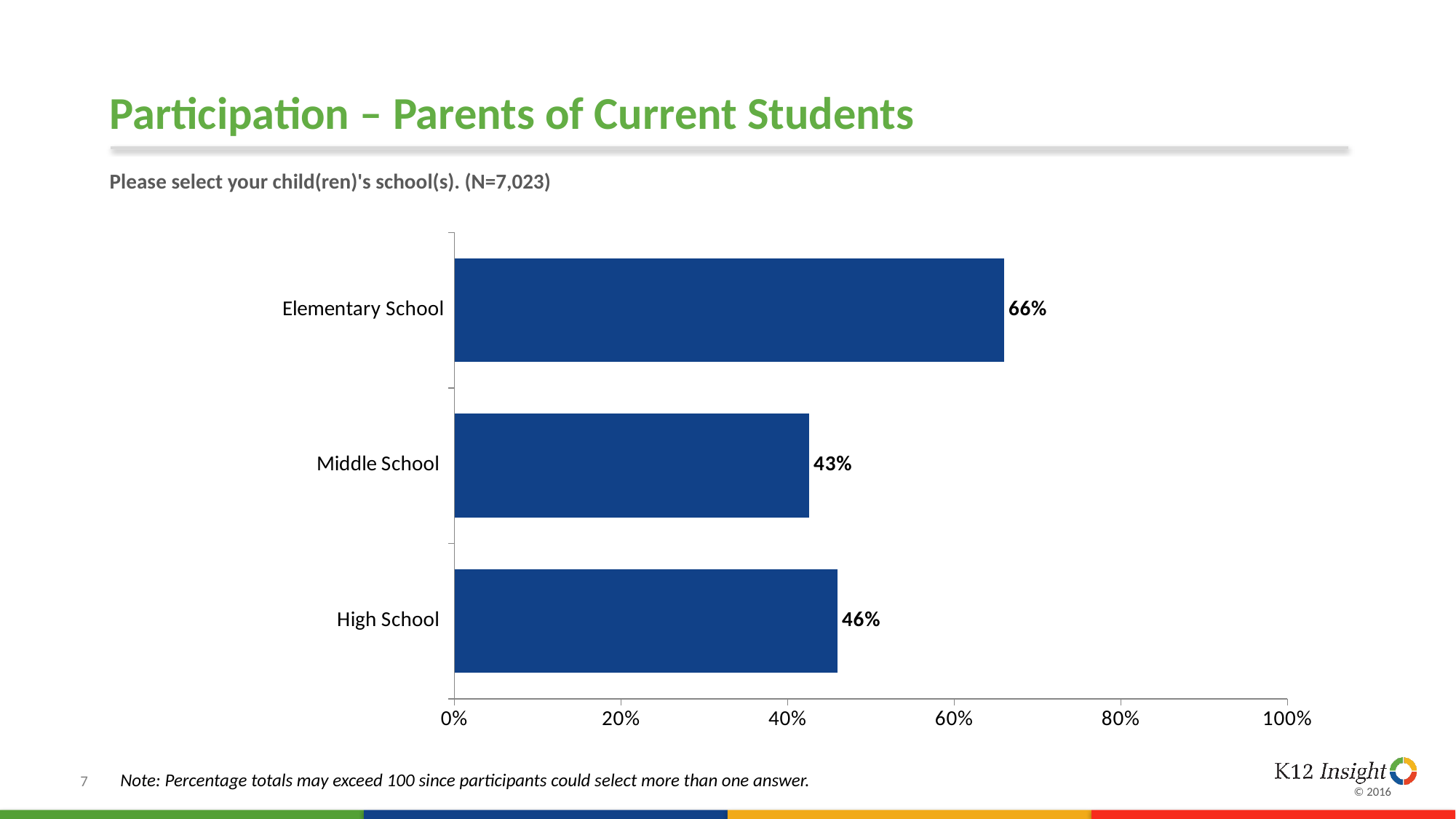
What percentage of parents selected Middle School? 43% What is the sample size (N) stated in the survey question above the chart? 7,023 What is the difference in percentage points between Elementary School and Middle School? 23 Which is larger, the value for Elementary School or the value for High School? Elementary School What kind of chart is shown on the slide? Bar chart Which school level has the lowest percentage? Middle School What percentage of parents selected High School? 46% Which school level has the highest percentage? Elementary School How many school levels are shown in the chart? 3 What is the difference in percentage points between High School and Middle School? 3 Is the value for Elementary School greater or less than 60%? greater What percentage of parents selected Elementary School? 66%